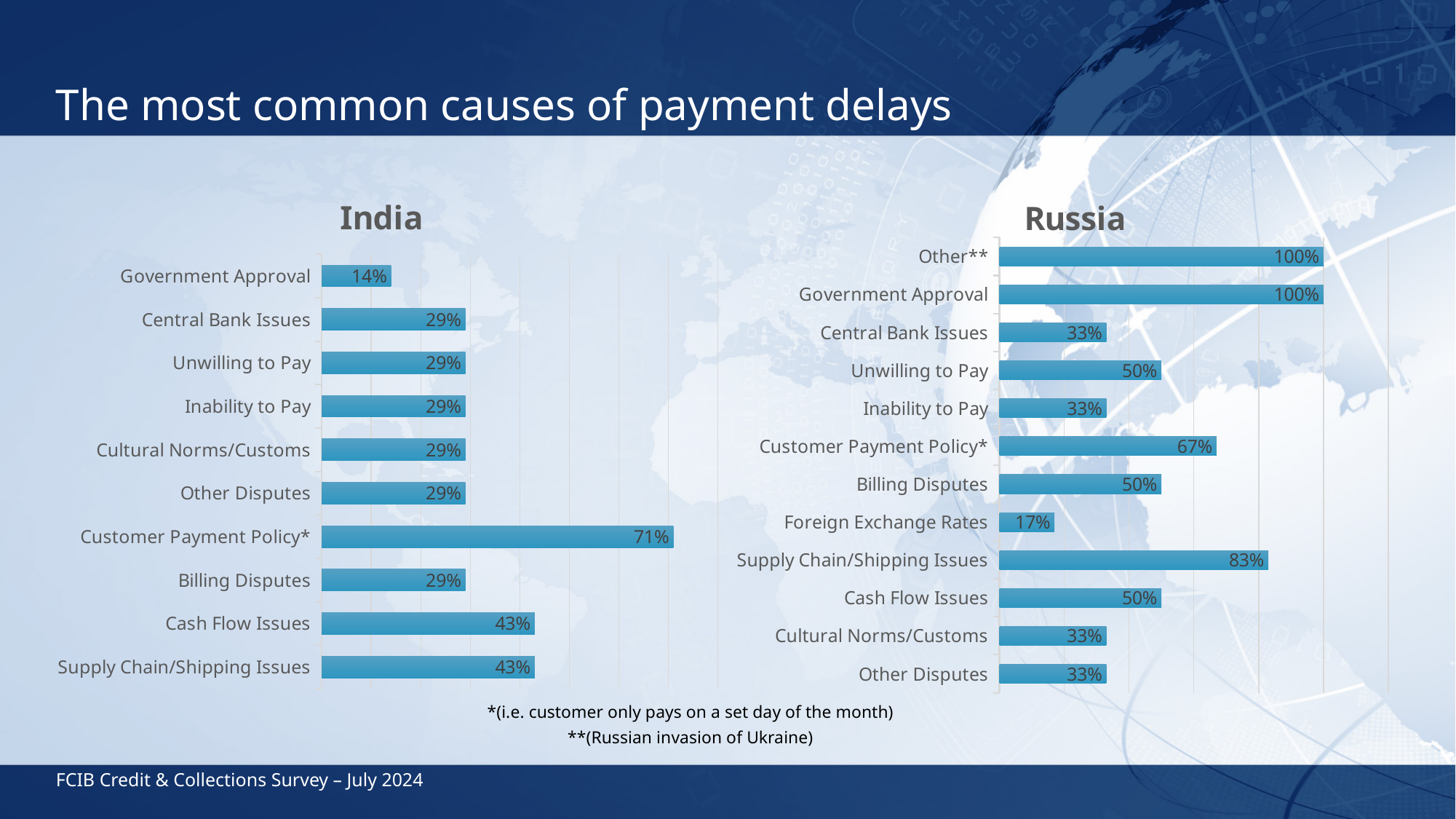
In the India chart, which category has the highest value? Customer Payment Policy* What kind of chart is the India chart? Bar chart In the India chart, what is the value for Customer Payment Policy*? 71% In the Russia chart, which is larger: Unwilling to Pay or Inability to Pay? Unwilling to Pay In the Russia chart, which category has the lowest value? Foreign Exchange Rates In the Russia chart, what is the difference between Supply Chain/Shipping Issues and Customer Payment Policy*? 16% In the India chart, which category has the lowest value? Government Approval In the Russia chart, what is the value for Foreign Exchange Rates? 17% In the Russia chart, what is the value for Supply Chain/Shipping Issues? 83% In the India chart, what is the value for Government Approval? 14% In the India chart, what is the difference between Cash Flow Issues and Government Approval? 29% How many categories are shown in the Russia chart? 12